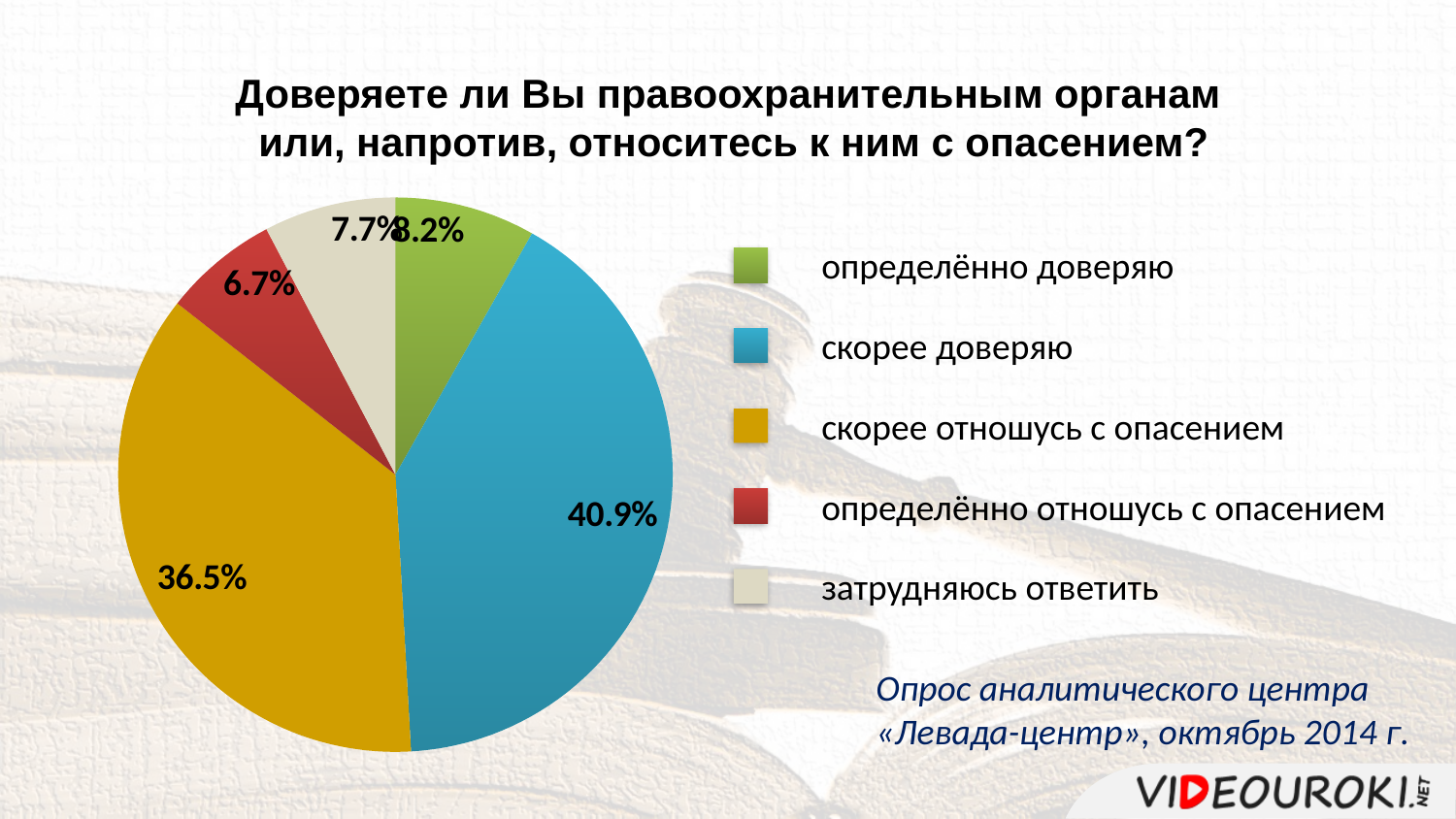
Which answer option has the smallest slice of the pie? определённо отношусь с опасением Which answer option has the largest slice of the pie? скорее доверяю What colour is the slice for «скорее доверяю»? blue How many slices does the pie chart have? 5 What share of respondents answered «затрудняюсь ответить»? 7.7% What share of respondents answered «скорее доверяю»? 40.9% By how many percentage points does «скорее доверяю» exceed «скорее отношусь с опасением»? 4.4 What kind of chart is shown on the slide? pie chart Which is larger: the share for «затрудняюсь ответить» or for «определённо отношусь с опасением»? затрудняюсь ответить Which organisation's survey is the chart based on, and when was it conducted? «Левада-центр», октябрь 2014 г. What share of respondents answered «скорее отношусь с опасением»? 36.5% What share of respondents answered «определённо отношусь с опасением»? 6.7%